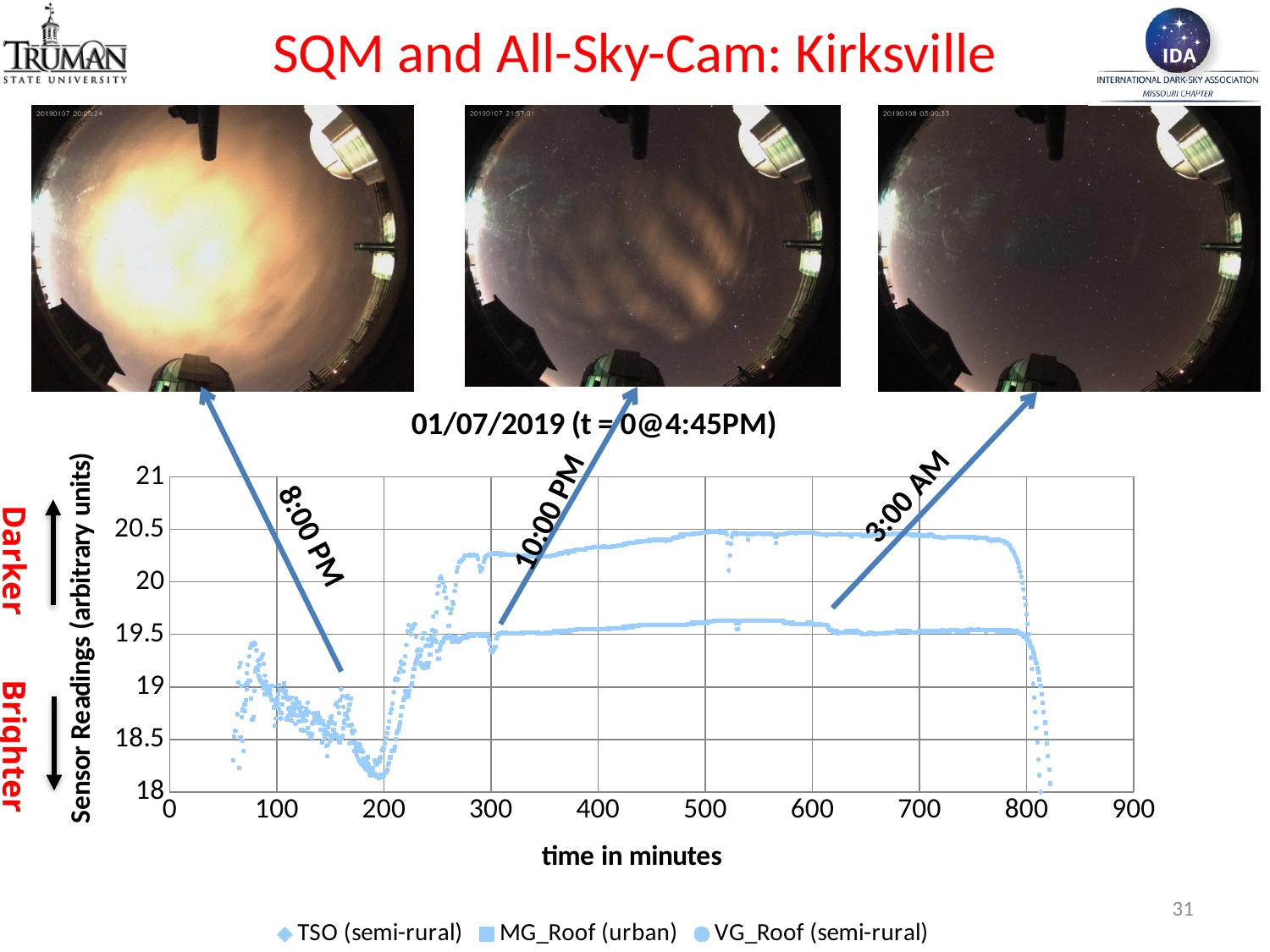
What is the label of the x axis of the chart? time in minutes Is the highest sensor reading plotted around 500 minutes greater or less than 20? greater What kind of chart is shown on the slide? scatter chart What is the largest value shown on the x axis of the chart? 900 Is the lower curve's reading at 500 minutes greater or less than 19? greater Do the sensor readings rise or fall between 200 and 300 minutes? rise What is the title of the chart? 01/07/2019 (t = 0@4:45PM) Do the sensor readings rise or fall between 100 and 200 minutes? fall Is the lowest sensor reading plotted around 200 minutes greater or less than 18.5? less Which series in the legend is labelled as urban? MG_Roof (urban) How many series does the chart legend list? 3